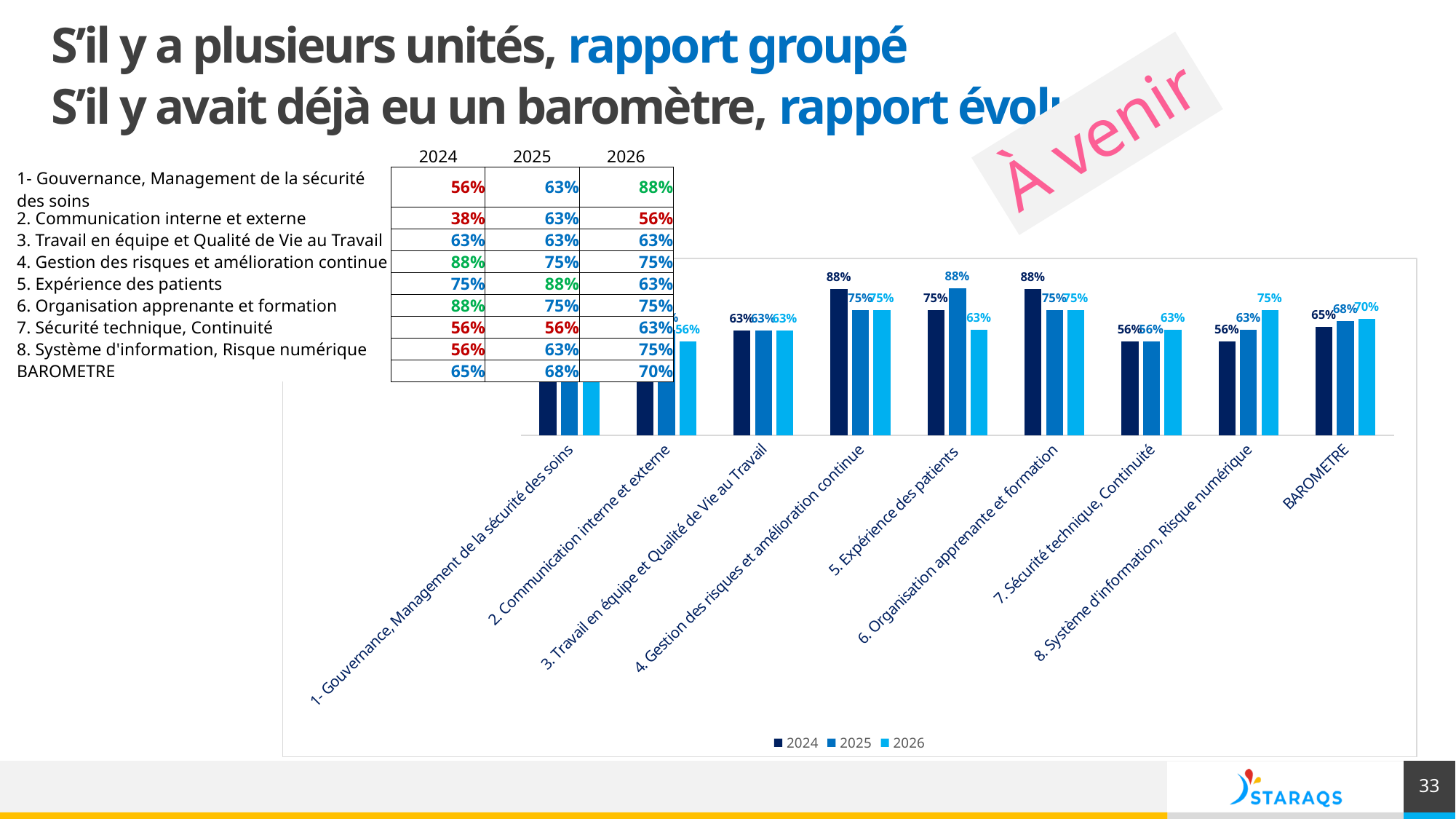
For "7. Sécurité technique, Continuité", which is larger: the 2024 value or the 2026 value? 2026 What is the 2025 value for BAROMETRE? 68% What kind of chart is shown on the slide? Bar chart Do the BAROMETRE values rise or fall from 2024 to 2026? Rise What is the 2024 value for "4. Gestion des risques et amélioration continue"? 88% What are the entries listed in the chart legend? 2024, 2025, 2026 How many categories are plotted along the x axis of the chart? 9 Which category has the lowest 2024 value? 2. Communication interne et externe What is the 2026 value for "8. Système d'information, Risque numérique"? 75% For "5. Expérience des patients", which year has the highest value? 2025 What is the difference between the 2026 and 2024 values for BAROMETRE? 5 percentage points How many series does the chart legend list? 3